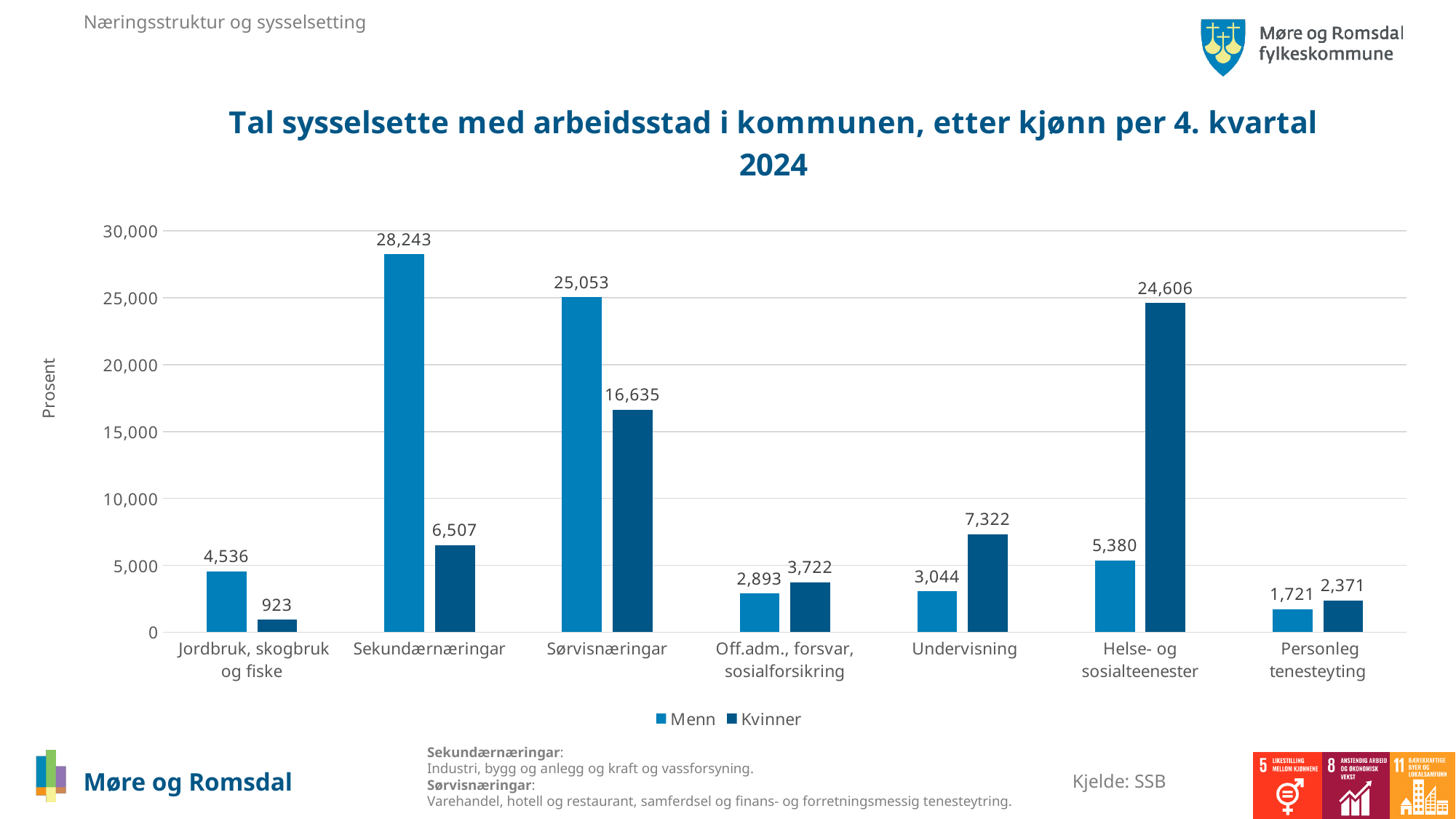
What is the value for Menn in Sekundærnæringar? 28,243 Is the value for Kvinner in Sørvisnæringar greater or less than 15,000? greater What is the difference between Menn and Kvinner in Sekundærnæringar? 21,736 What kind of chart is shown on the slide? Bar chart How many categories are shown on the x axis? 7 In Undervisning, which is larger, Menn or Kvinner? Kvinner Which category has the lowest value for Menn? Personleg tenesteyting What is the value for Kvinner in Jordbruk, skogbruk og fiske? 923 What is the value for Kvinner in Helse- og sosialteenester? 24,606 Which category has the highest value for Kvinner? Helse- og sosialteenester What is the difference between Kvinner and Menn in Helse- og sosialteenester? 19,226 How many series does the legend list? 2